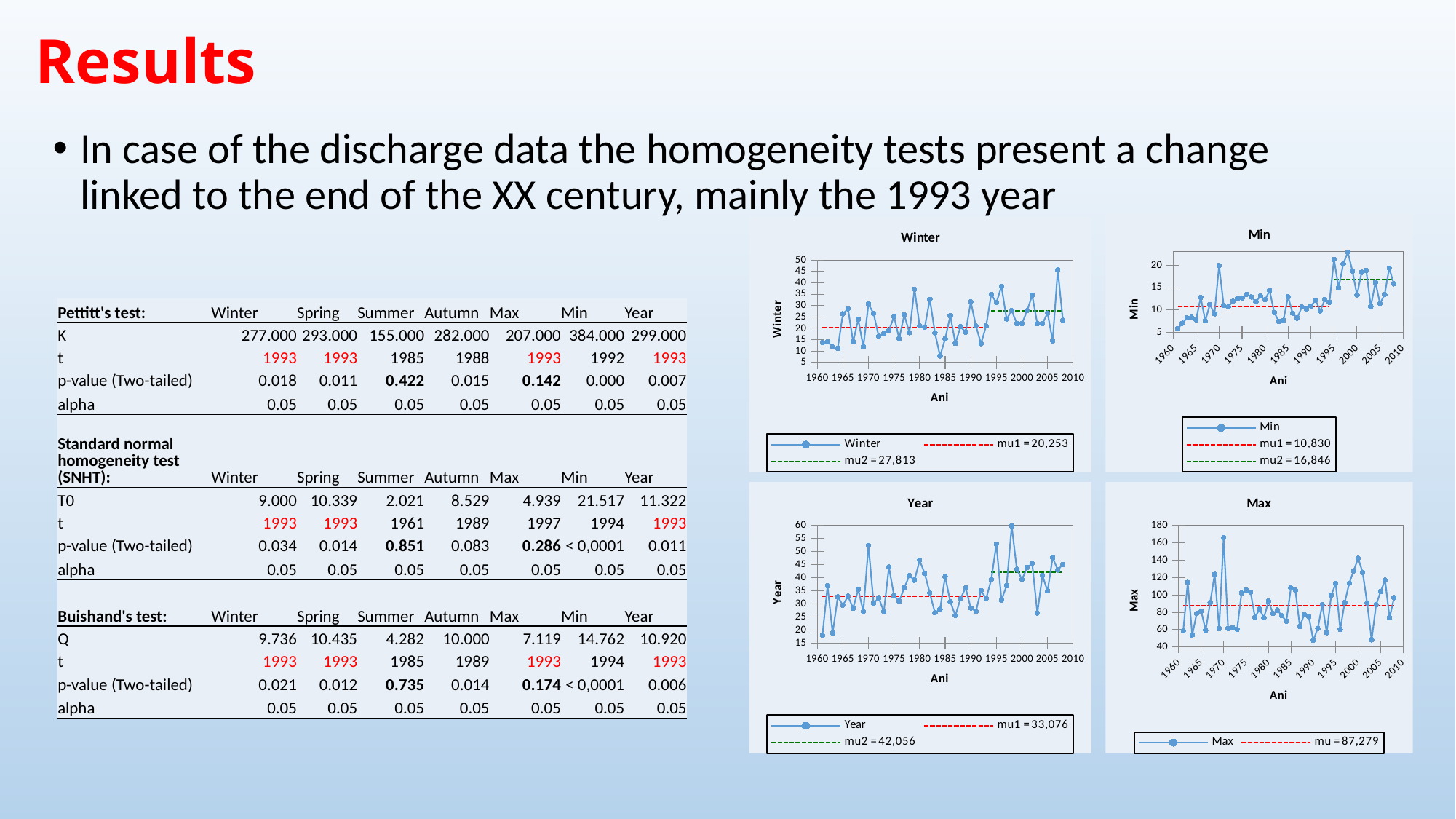
In the "Year" chart, what value does the legend give for mu1? 33,076 What is the x-axis title of the "Min" chart? Ani What kind of chart is the "Winter" chart? line chart In the "Year" chart, do the values generally rise or fall from the 1960s to the 2000s? rise How many entries does the legend of the "Winter" chart list? 3 How many entries does the legend of the "Max" chart list? 2 In the "Max" chart, is the highest plotted value (around 1970) greater or less than 140? greater In the "Winter" chart, what value does the legend give for mu1? 20,253 In the "Max" chart, what value does the legend give for mu? 87,279 In the "Min" chart, what value does the legend give for mu2? 16,846 In the "Winter" chart, what value does the legend give for mu2? 27,813 In the "Year" chart, which is larger, mu1 or mu2? mu2